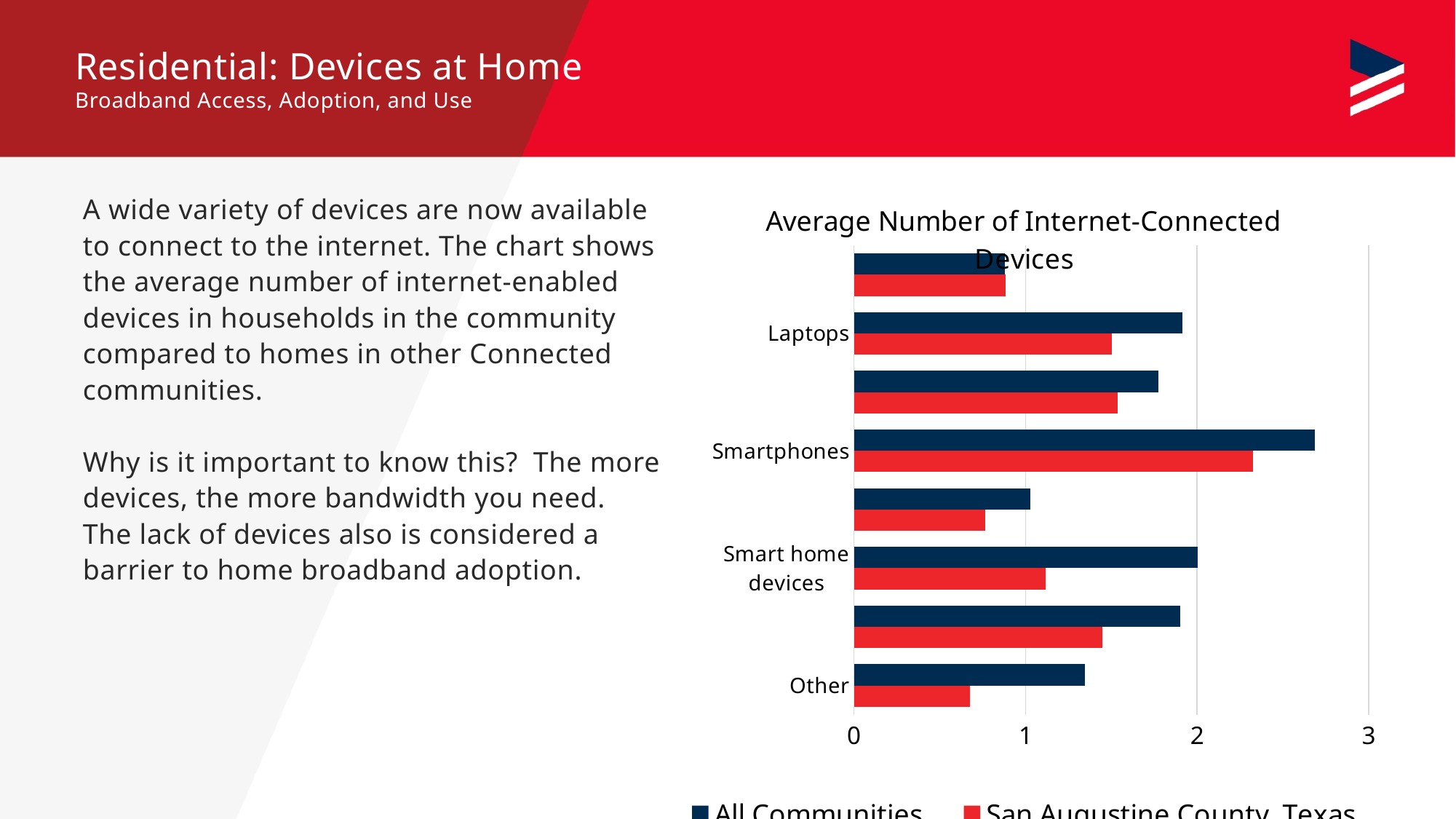
Is the value for Smartphones for San Augustine County, Texas greater or less than 2? greater Which labeled category has the lowest value for San Augustine County, Texas? Other Is the value for Laptops for San Augustine County, Texas greater or less than 1? greater For Smartphones, which series has the larger value: All Communities or San Augustine County, Texas? All Communities How many series does the chart's legend list? 2 Which series is shown in red in the chart? San Augustine County, Texas What type of chart is shown on the slide? Bar chart Is the value for Smartphones for All Communities greater or less than 2? greater What is the title of the chart? Average Number of Internet-Connected Devices For Other, which series has the larger value: All Communities or San Augustine County, Texas? All Communities Which labeled category has the highest value for All Communities? Smartphones